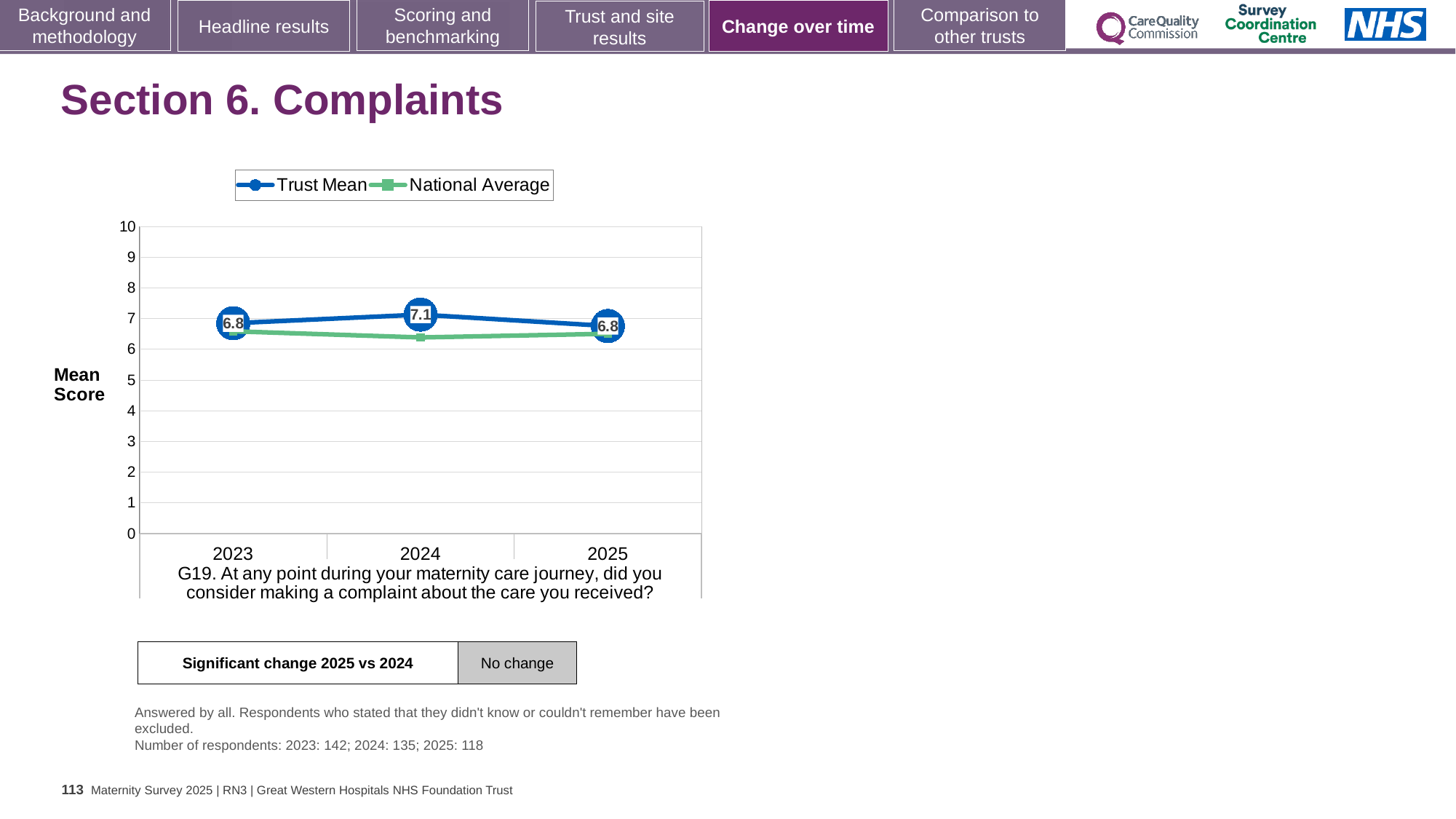
What is the Trust Mean score for 2025? 6.8 What kind of chart is shown on the slide? line chart What is the Trust Mean score for 2024? 7.1 What is the Trust Mean score for 2023? 6.8 In 2024, which is higher: the Trust Mean or the National Average? Trust Mean How many series does the chart legend list? 2 How many years are shown on the x axis of the chart? 3 Does the Trust Mean rise or fall from 2024 to 2025? fall In which year is the Trust Mean highest? 2024 Is the National Average value for 2024 greater or less than 7? less What is the difference between the Trust Mean in 2024 and in 2023? 0.3 What is the label on the y axis of the chart? Mean Score